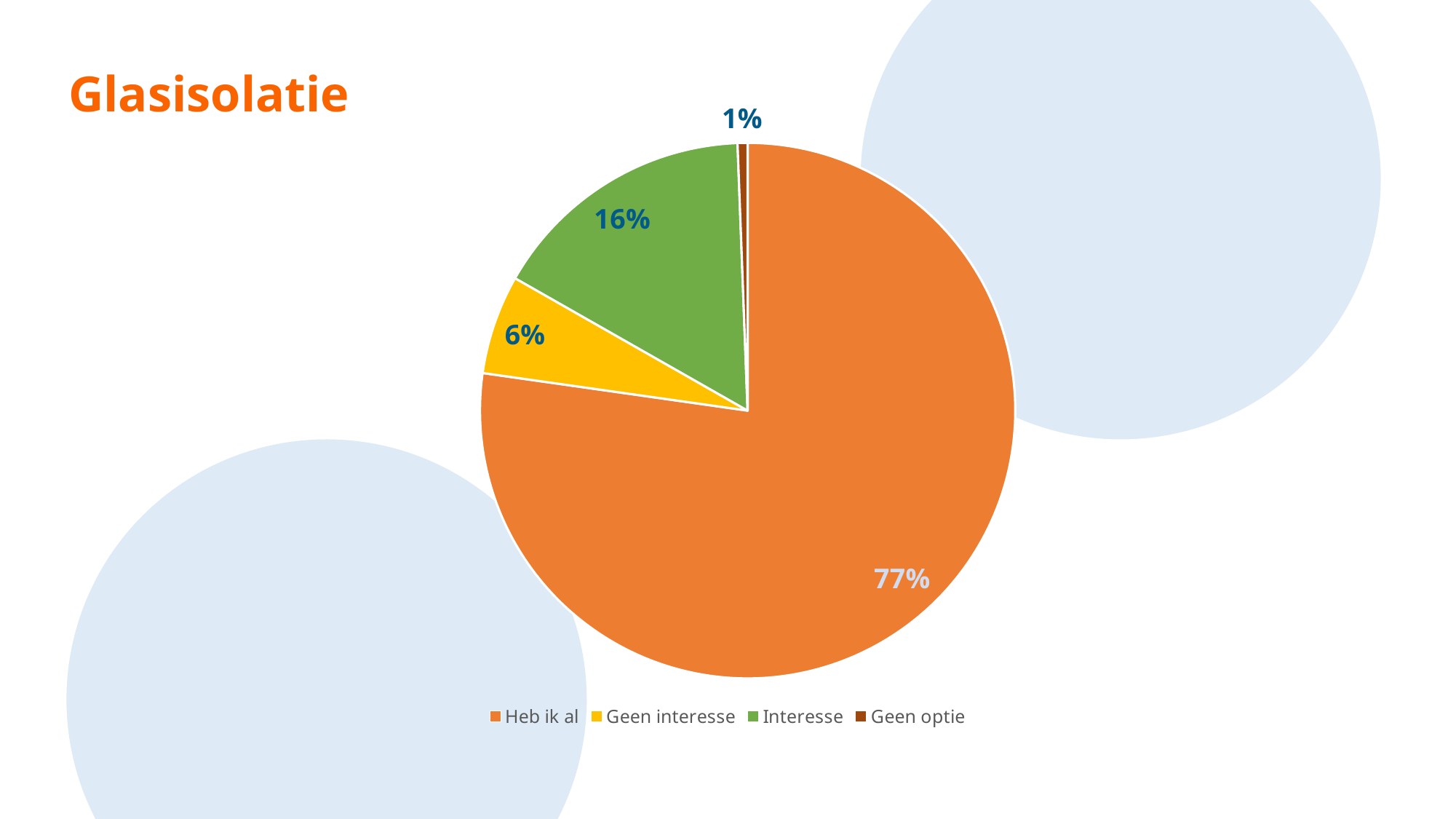
How many categories does the legend list? 4 What percentage of the pie is 'Interesse'? 16% What colour is the 'Interesse' slice? green What percentage of the pie is 'Heb ik al'? 77% What kind of chart is shown on the slide? pie chart What percentage of the pie is 'Geen interesse'? 6% What is the title of the slide? Glasisolatie Which category has the smallest share of the pie? Geen optie Which is larger, the share for 'Interesse' or the share for 'Geen interesse'? Interesse What percentage of the pie is 'Geen optie'? 1% What is the difference in percentage points between 'Interesse' and 'Geen interesse'? 10 Which category has the largest share of the pie? Heb ik al